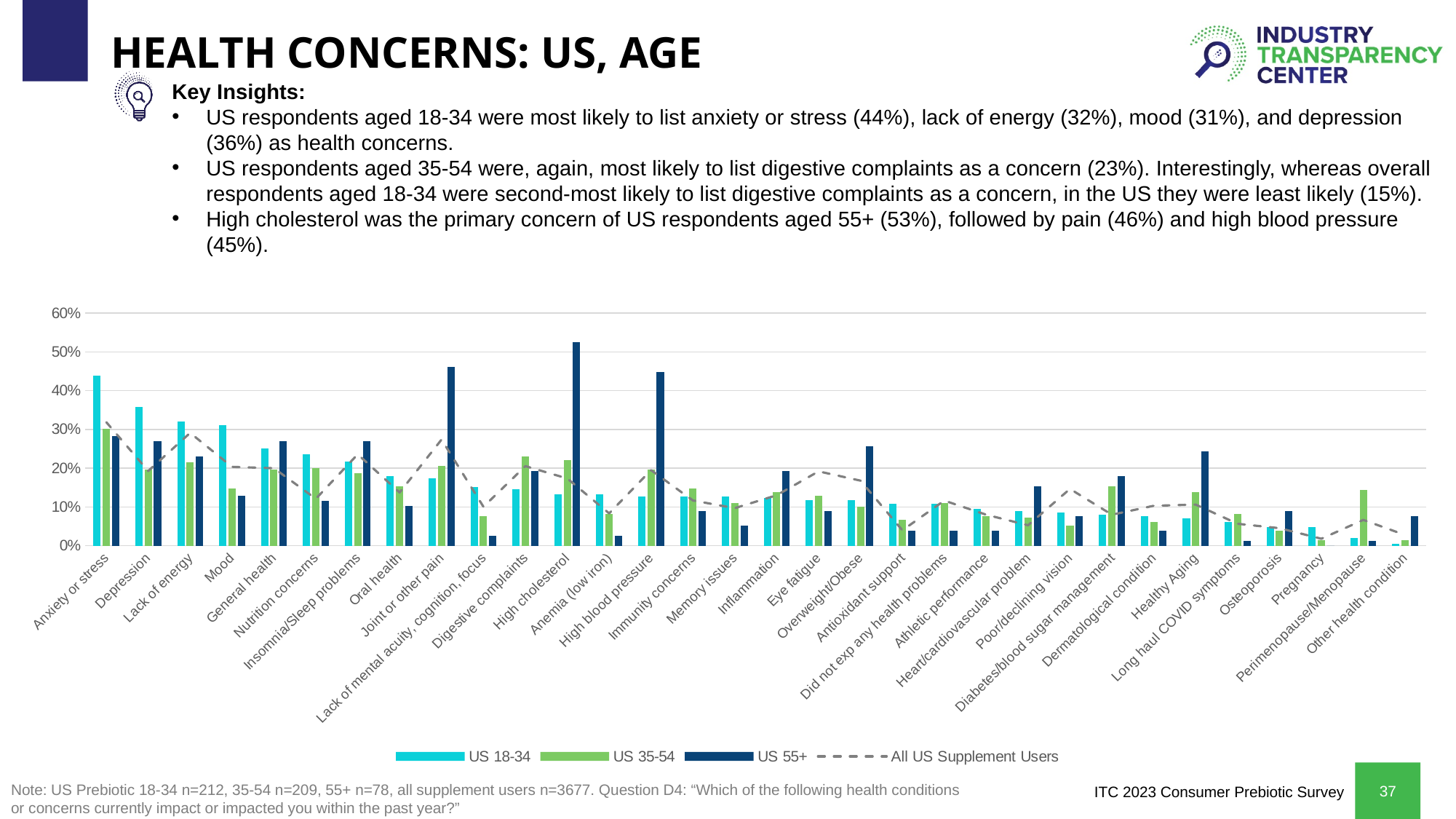
How many health concern categories are shown on the x axis of the chart? 32 Is the US 18-34 value for Anxiety or stress greater or less than 40%? greater What kind of chart is shown on the slide? Combination bar and line chart How many series does the chart legend list? 4 For High blood pressure, which is larger: the US 18-34 value or the US 55+ value? US 55+ Is the US 55+ value for High blood pressure greater or less than 40%? greater For the US 18-34 series, which health concern has the highest bar? Anxiety or stress Which series in the legend is drawn as a dashed line rather than bars? All US Supplement Users Is the US 18-34 value for Digestive complaints greater or less than 20%? less For the US 55+ series, which health concern has the highest bar? High cholesterol For Depression, which is larger: the US 18-34 value or the US 55+ value? US 18-34